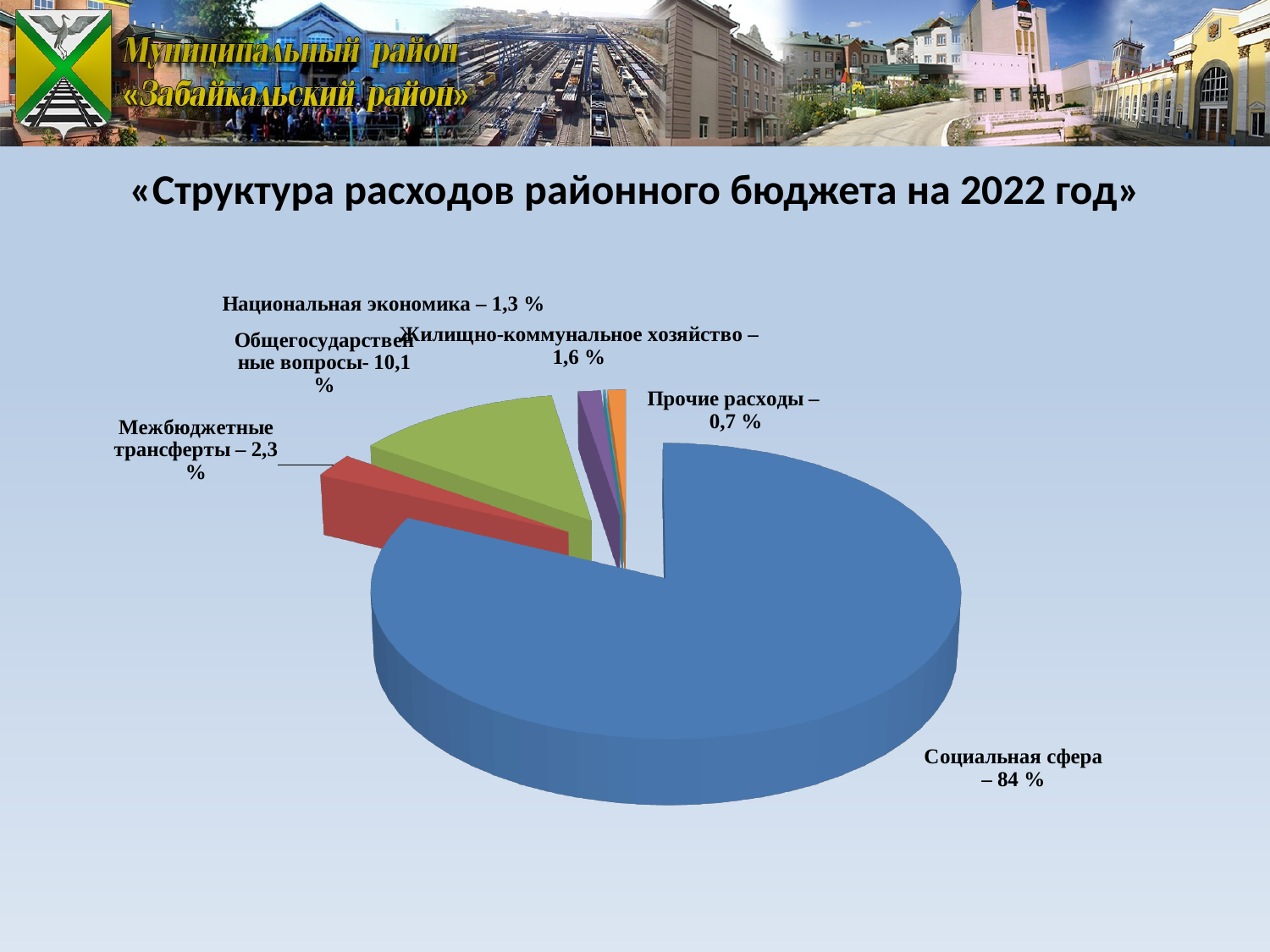
What share is labelled for Жилищно-коммунальное хозяйство? 1,6 % What kind of chart is shown on the slide? pie chart What share is labelled for Общегосударственные вопросы? 10,1 % What share is labelled for Национальная экономика? 1,3 % Which is larger, the share for Межбюджетные трансферты or the share for Жилищно-коммунальное хозяйство? Межбюджетные трансферты How many categories are shown in the pie chart? 6 What share is labelled for Прочие расходы? 0,7 % Which category has the largest share of the pie? Социальная сфера What is the title of the chart on the slide? «Структура расходов районного бюджета на 2022 год» What share is labelled for Межбюджетные трансферты? 2,3 % What share of the budget expenditure is labelled for Социальная сфера? 84 % Which category has the smallest share of the pie? Прочие расходы